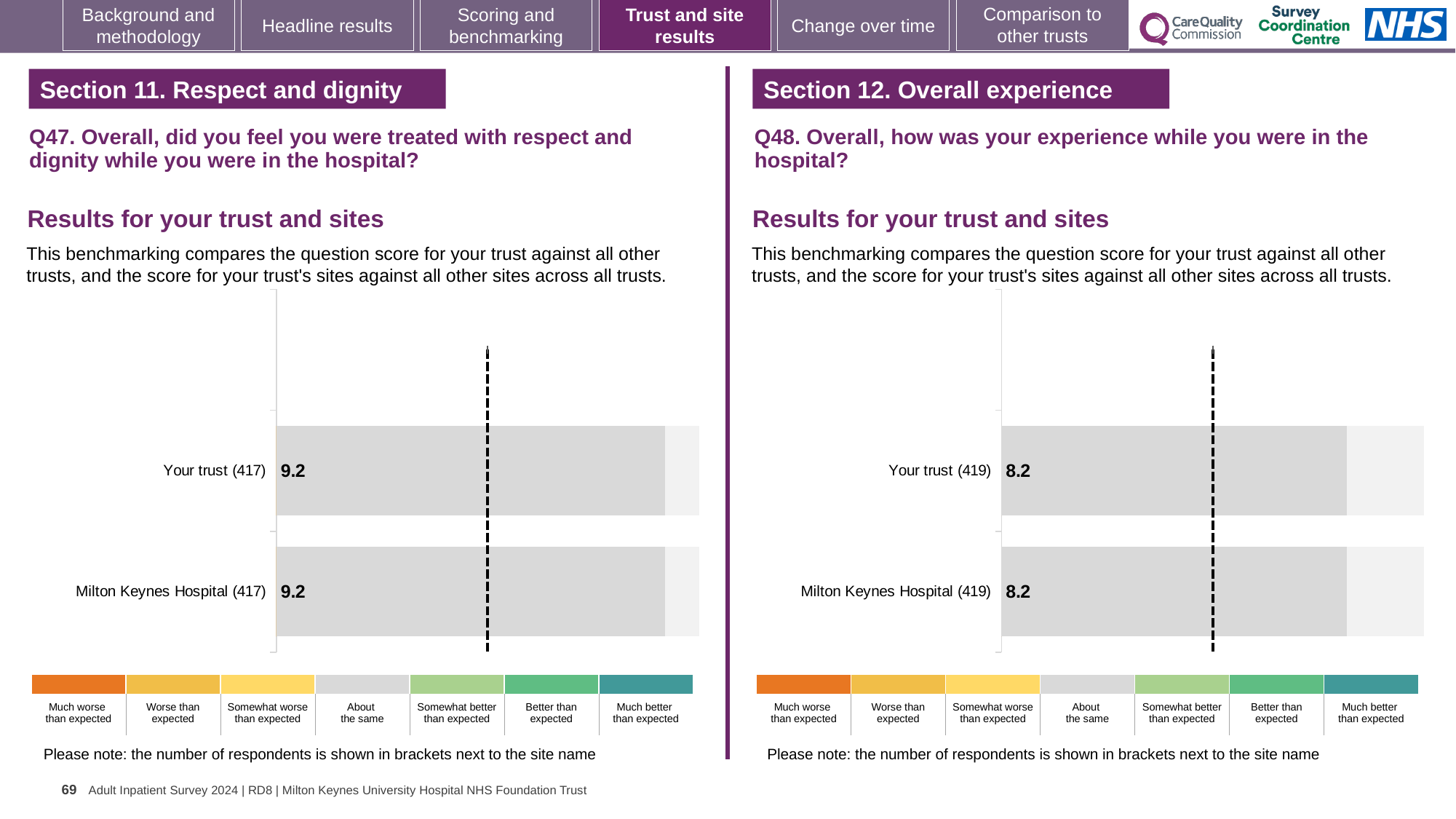
On the left chart (Q47, Respect and dignity), what is the score for Milton Keynes Hospital? 9.2 What kind of chart is used on the left for Q47? Bar chart On the left chart (Q47), what is the difference between the score for Your trust and the score for Milton Keynes Hospital? 0.0 On the right chart (Q48, Overall experience), what is the score for Milton Keynes Hospital? 8.2 On the right chart (Q48), what is the difference between the score for Your trust and the score for Milton Keynes Hospital? 0.0 How many categories does the colour key below the right chart (Q48) list? 7 How many bars are plotted on the right chart (Q48, Overall experience)? 2 On the right chart (Q48), how many respondents are shown in brackets next to Milton Keynes Hospital? 419 How many bars are plotted on the left chart (Q47, Respect and dignity)? 2 On the left chart (Q47, Respect and dignity), what is the score for Your trust? 9.2 On the left chart (Q47), how many respondents are shown in brackets next to Your trust? 417 On the right chart (Q48, Overall experience), what is the score for Your trust? 8.2